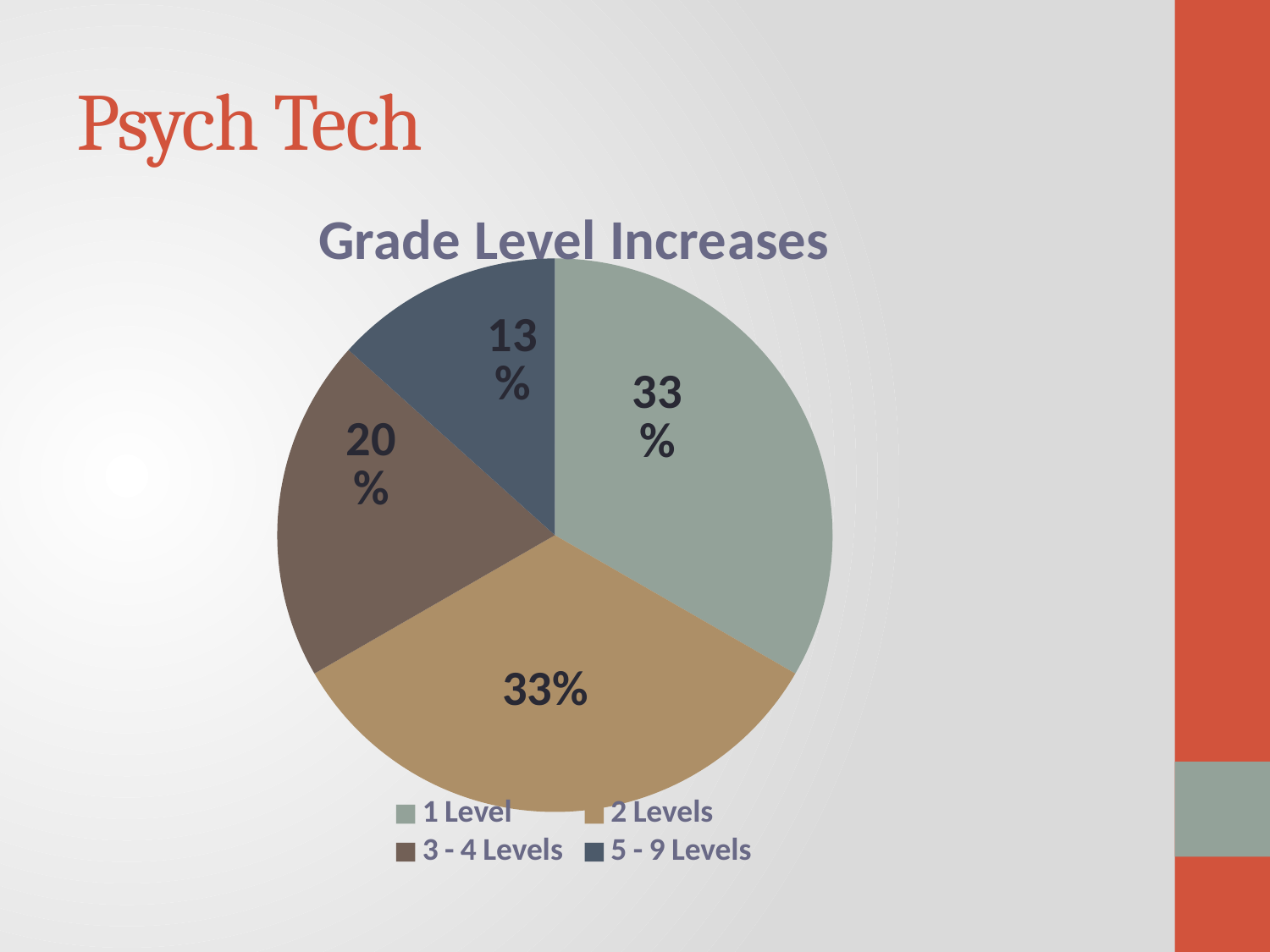
Which slice is larger, 3 - 4 Levels or 5 - 9 Levels? 3 - 4 Levels What percentage of the pie is the 3 - 4 Levels slice? 20% What is the title of the chart? Grade Level Increases What type of chart is shown on the slide? pie chart How many entries does the legend list? 4 What percentage of the pie is the 2 Levels slice? 33% How many categories does the pie chart show? 4 Which slice is larger, 1 Level or 3 - 4 Levels? 1 Level What percentage of the pie is the 1 Level slice? 33% What is the difference in percentage points between the 3 - 4 Levels slice and the 5 - 9 Levels slice? 7 Which category has the smallest slice of the pie? 5 - 9 Levels What percentage of the pie is the 5 - 9 Levels slice? 13%